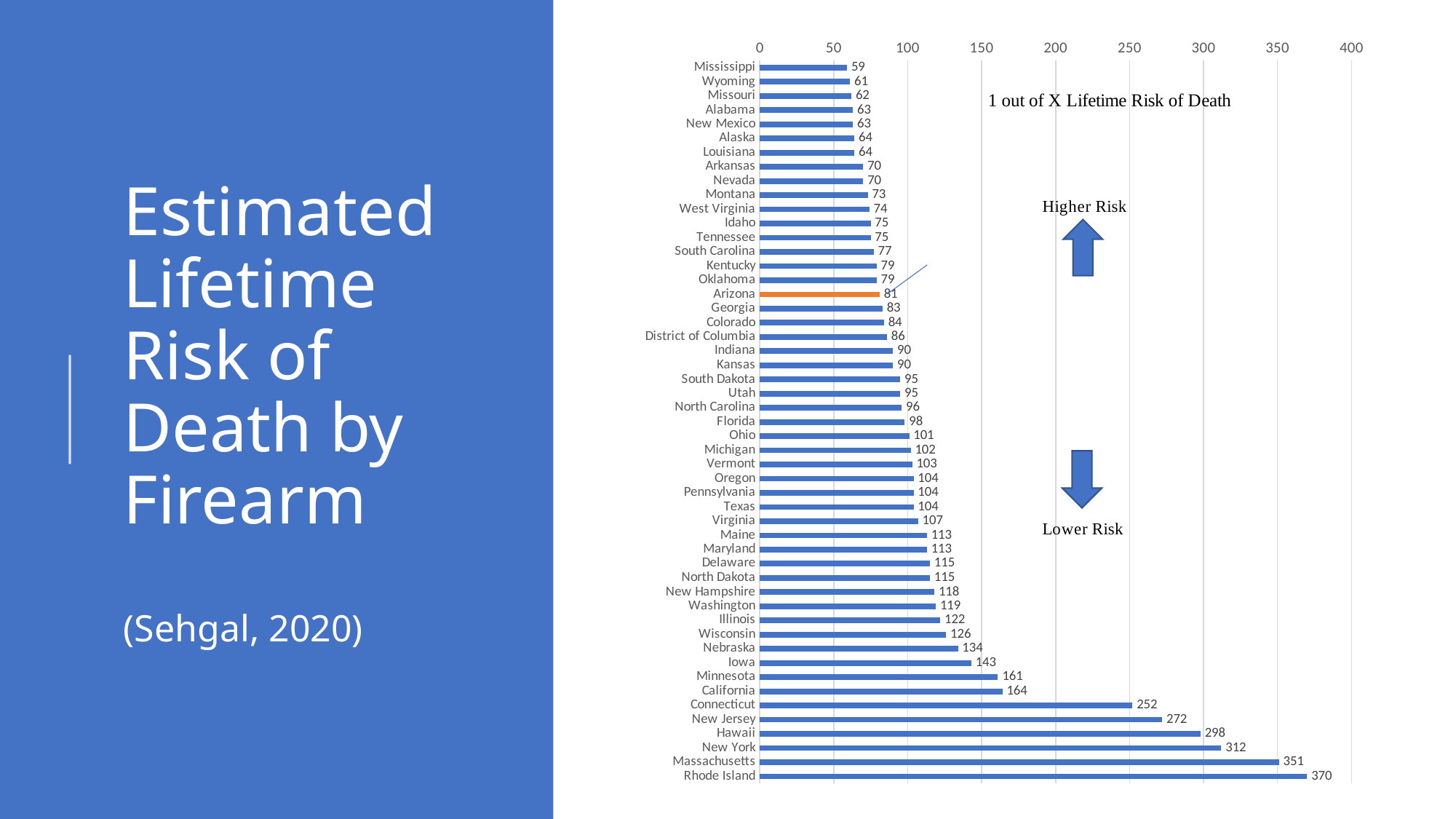
Is the value for New Jersey greater or less than 250? greater What is the difference between the values for New York and Hawaii? 14 How many states or districts are listed on the chart? 51 Which bar is highlighted in orange on the chart? Arizona What is the value for Texas? 104 What is the value for Massachusetts? 351 Which has a larger value, Connecticut or California? Connecticut What is the value for Arizona? 81 What kind of chart is shown on the slide? Bar chart Which state has the lowest value on the chart? Mississippi Which state has the highest value on the chart? Rhode Island What is the difference between the values for Rhode Island and Mississippi? 311